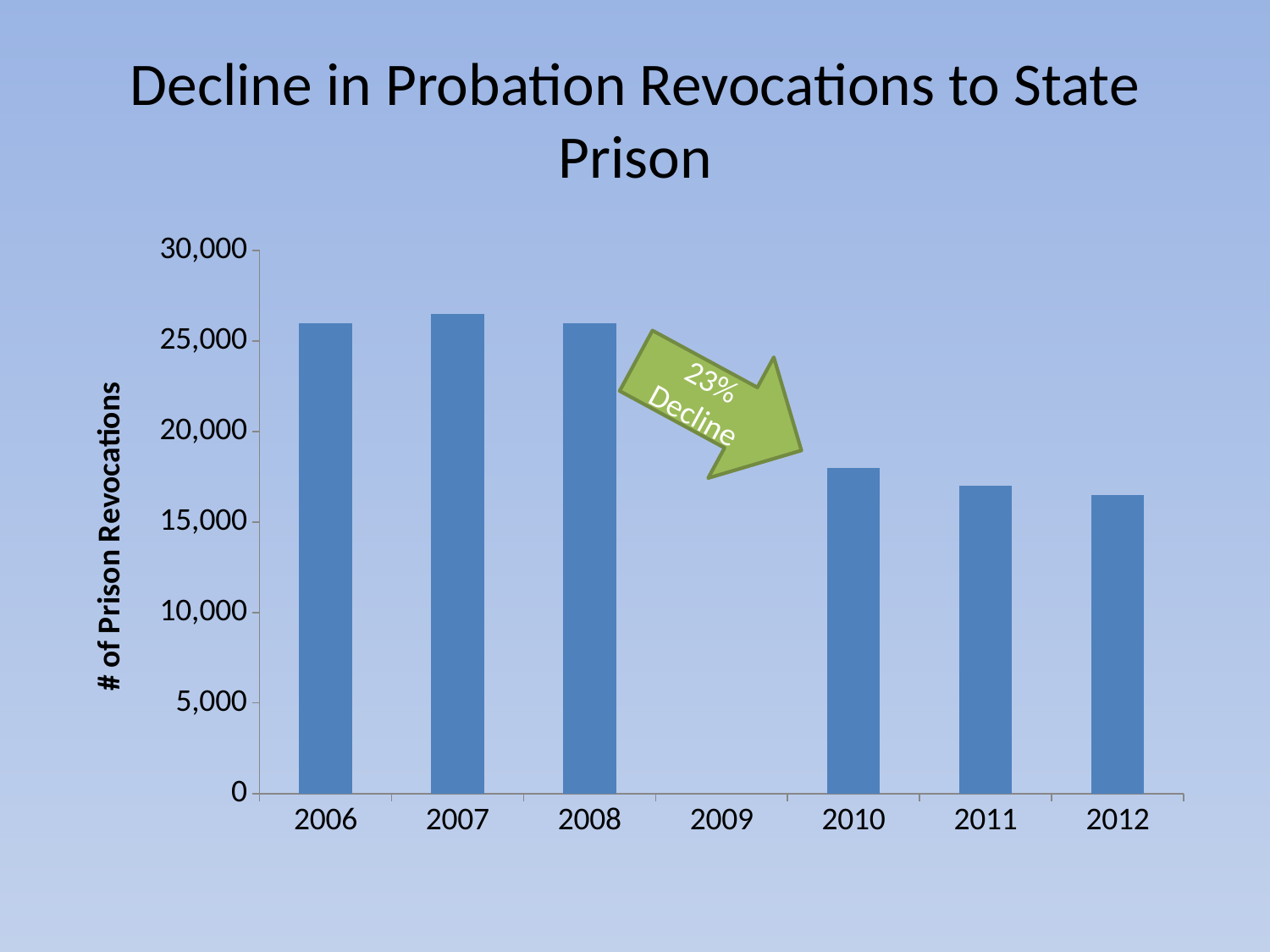
Which year has the larger value, 2008 or 2010? 2008 Is the value for 2011 greater or less than 15,000? greater Is the value for 2012 greater or less than 20,000? less How many years are labelled on the x axis of the chart? 7 Is the value for 2007 greater or less than 25,000? greater What kind of chart is shown on the slide? bar chart What is the label on the vertical axis of the chart? # of Prison Revocations Do the values generally rise or fall from 2006 to 2012? fall What text is written on the green arrow in the chart? 23% Decline